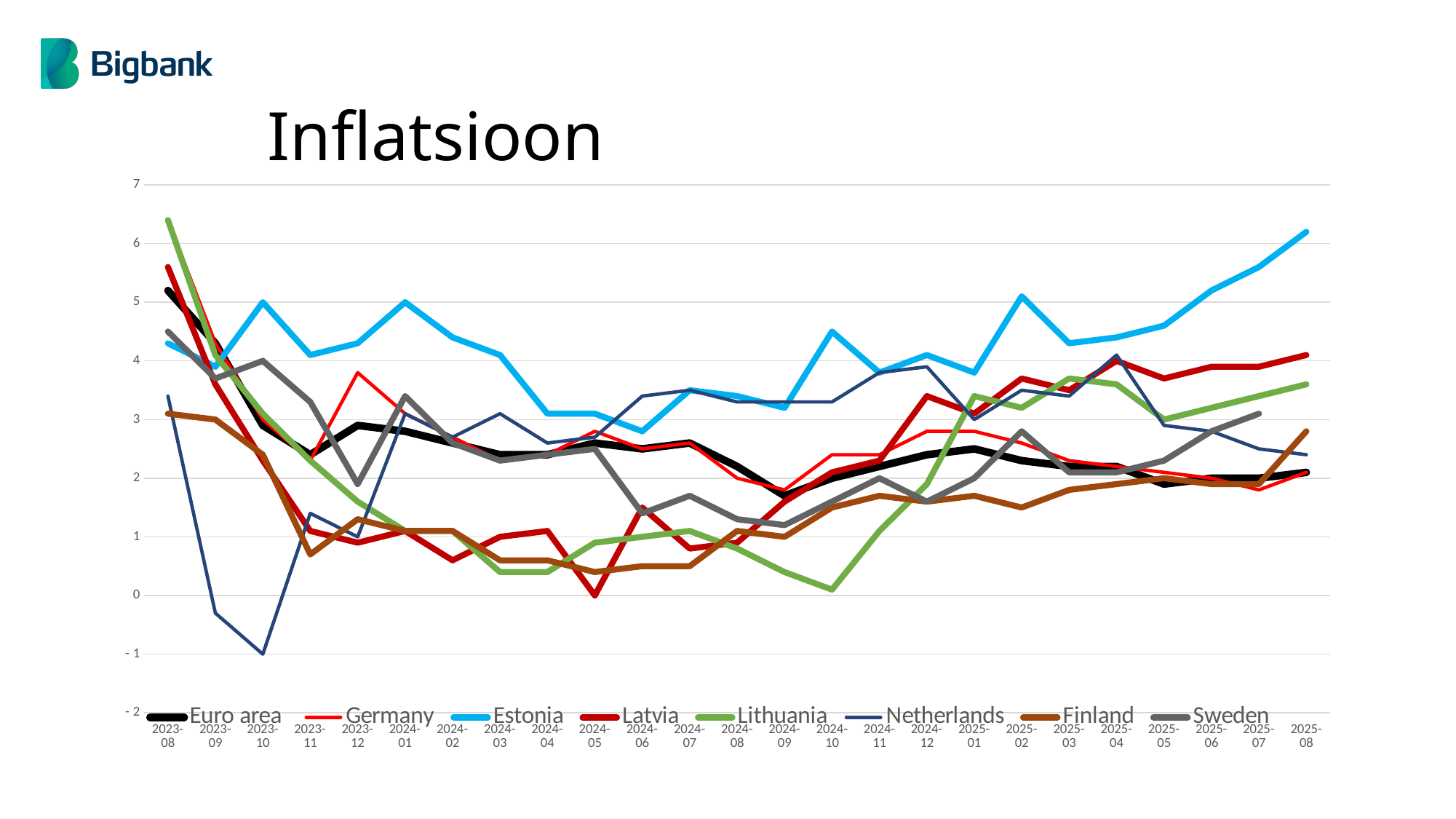
Is the value for Estonia at 2025-08 greater or less than 5? greater Which series has the highest value at 2025-08? Estonia What kind of chart is shown on the slide? line chart Which series has the lowest value at 2024-10? Lithuania How many series does the legend list? 8 What is the title of the chart? Inflatsioon Is the value for Netherlands at 2023-10 greater or less than 0? less Does the Estonia line rise or fall from 2025-03 to 2025-08? rise How many monthly points are plotted along the x axis? 25 Is the value for Lithuania at 2024-10 greater or less than 1? less Which series has the lowest value at 2023-10? Netherlands